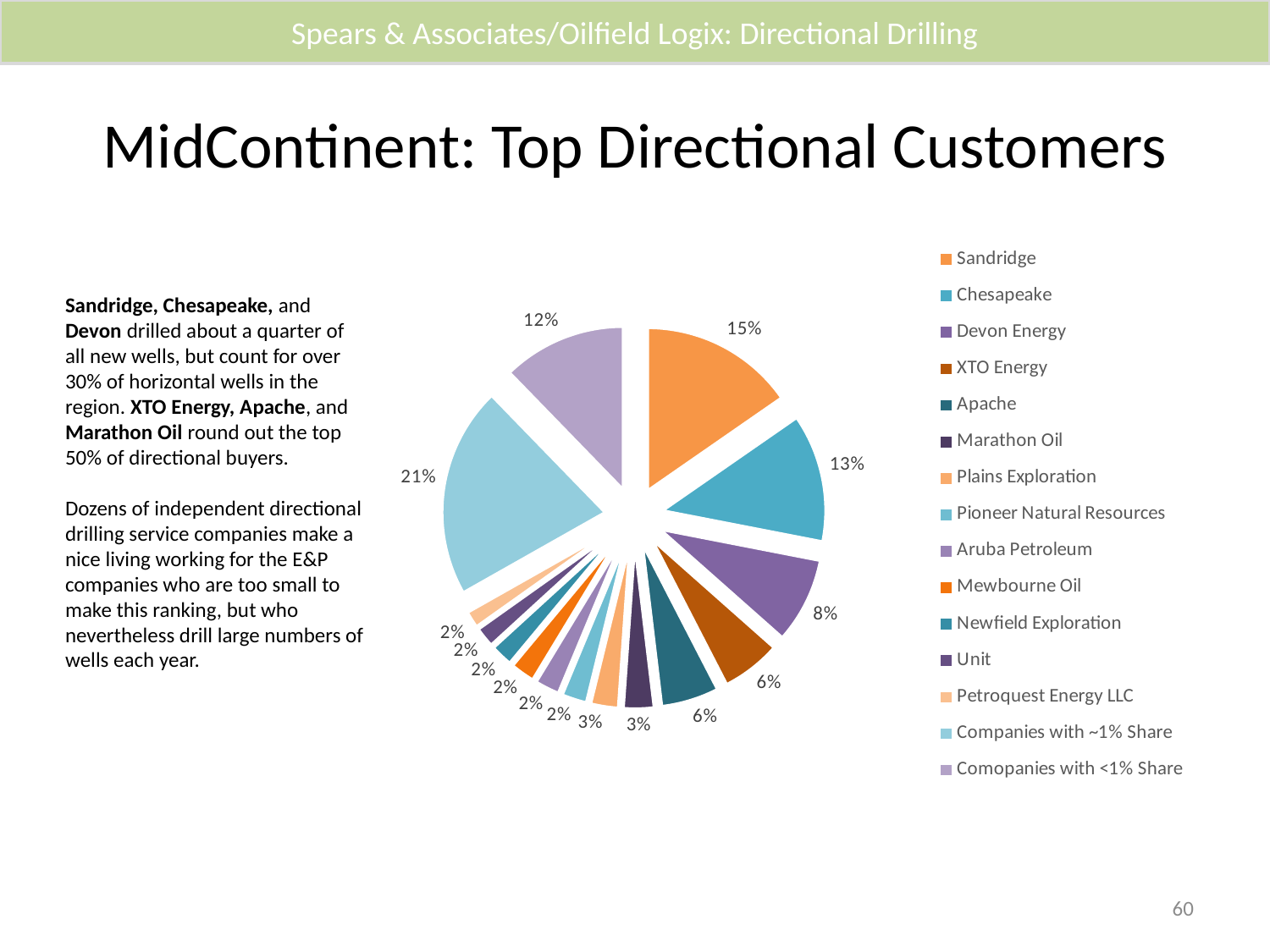
Which legend category has the largest slice of the pie? Companies with ~1% Share What is the difference between the Sandridge and Chesapeake shares? 2% What share of the pie does Sandridge hold? 15% Which is larger, the share for Sandridge or the share for Devon Energy? Sandridge What is the value shown for Comopanies with <1% Share? 12% What is the title of the slide containing the chart? MidContinent: Top Directional Customers How many categories does the legend list? 15 What is the value shown for Companies with ~1% Share? 21% What is the value shown for Chesapeake? 13% What is the value shown for XTO Energy? 6% What is the value shown for Devon Energy? 8% What kind of chart is shown on the slide? pie chart